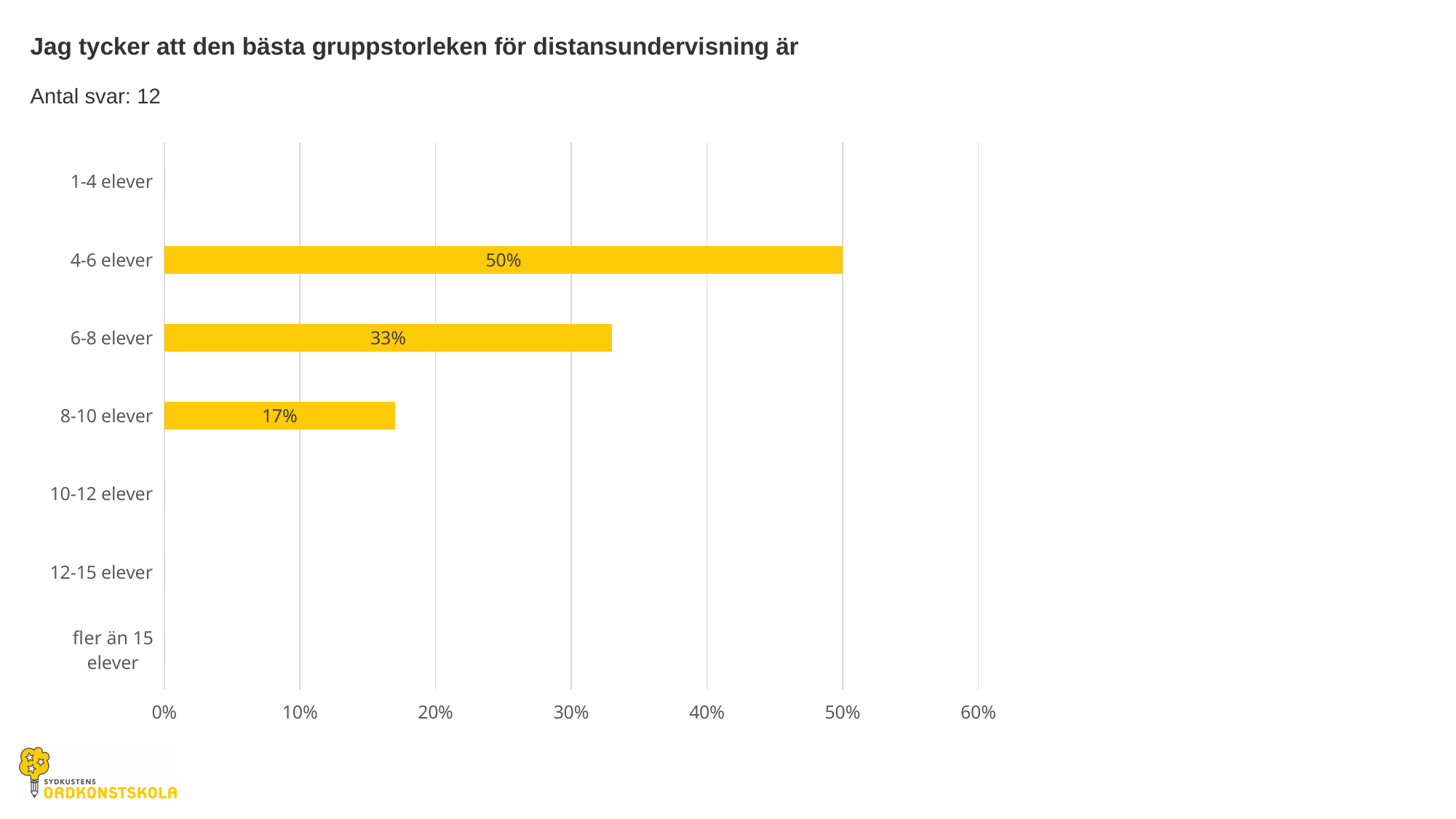
What percentage of respondents chose "4-6 elever" as the best group size? 50% What is the difference between the values for "6-8 elever" and "8-10 elever"? 16% What is the title of the chart? Jag tycker att den bästa gruppstorleken för distansundervisning är How many group size categories are listed on the vertical axis? 7 Is the value for "6-8 elever" greater or less than 40%? less What is the value shown for "6-8 elever"? 33% What kind of chart is shown on the slide? bar chart How many responses (Antal svar) does the slide report? 12 Which is larger, the value for "6-8 elever" or the value for "8-10 elever"? 6-8 elever What is the value shown for "8-10 elever"? 17% What is the difference between the values for "4-6 elever" and "6-8 elever"? 17% Which group size category has the highest value? 4-6 elever